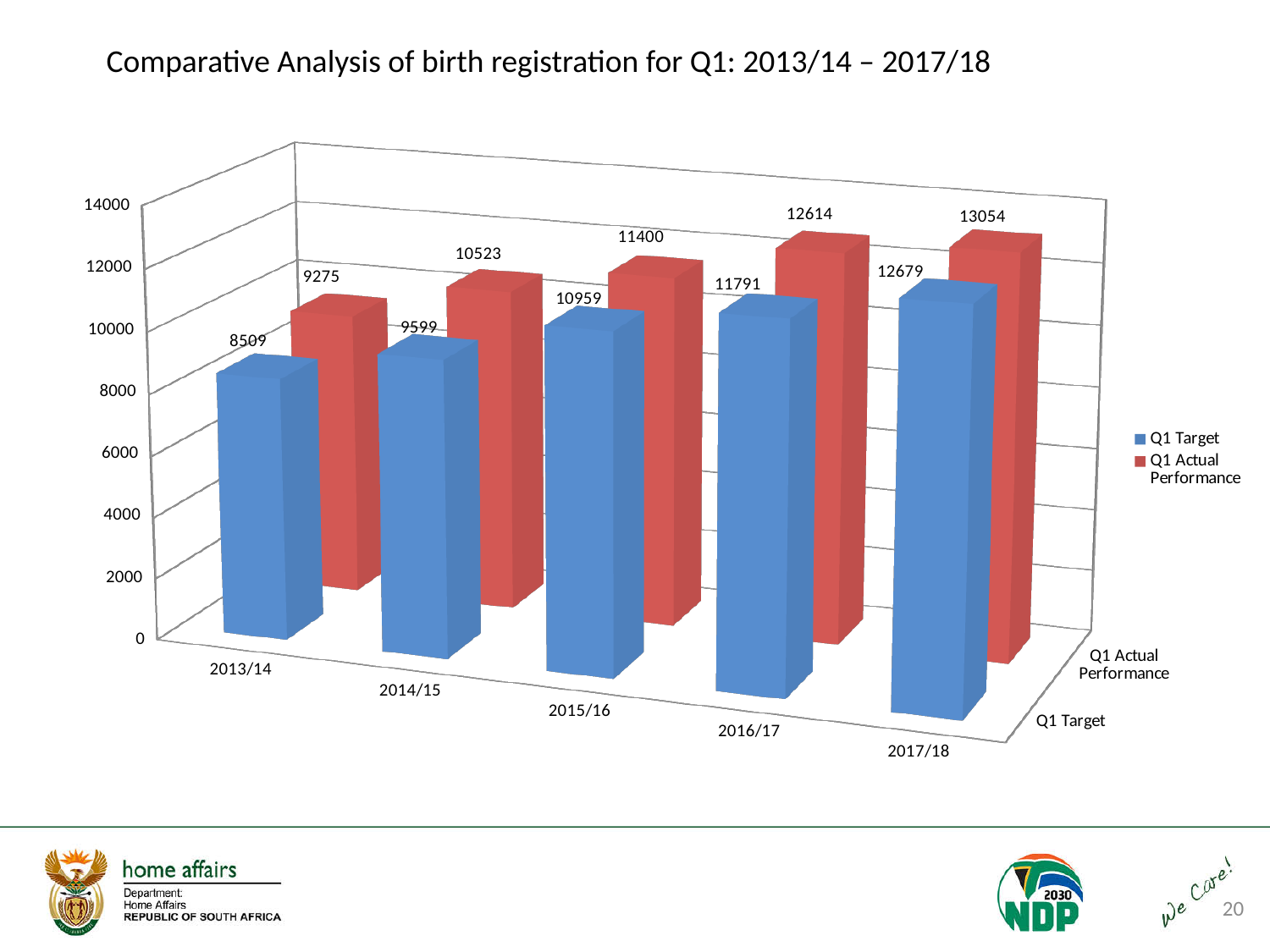
Is the Q1 Target for 2017/18 greater or less than 12000? greater What kind of chart is shown on the slide? Bar chart Which is larger in 2014/15, the Q1 Target or the Q1 Actual Performance? Q1 Actual Performance What is the Q1 Actual Performance value for 2017/18? 13054 Which year has the lowest Q1 Target? 2013/14 How many years are shown on the x axis? 5 What is the Q1 Target value for 2013/14? 8509 How many series does the legend list? 2 What is the Q1 Actual Performance value for 2015/16? 11400 Which year has the highest Q1 Actual Performance? 2017/18 Does the Q1 Target rise or fall from 2013/14 to 2017/18? Rise What is the difference between Q1 Actual Performance and Q1 Target in 2016/17? 823